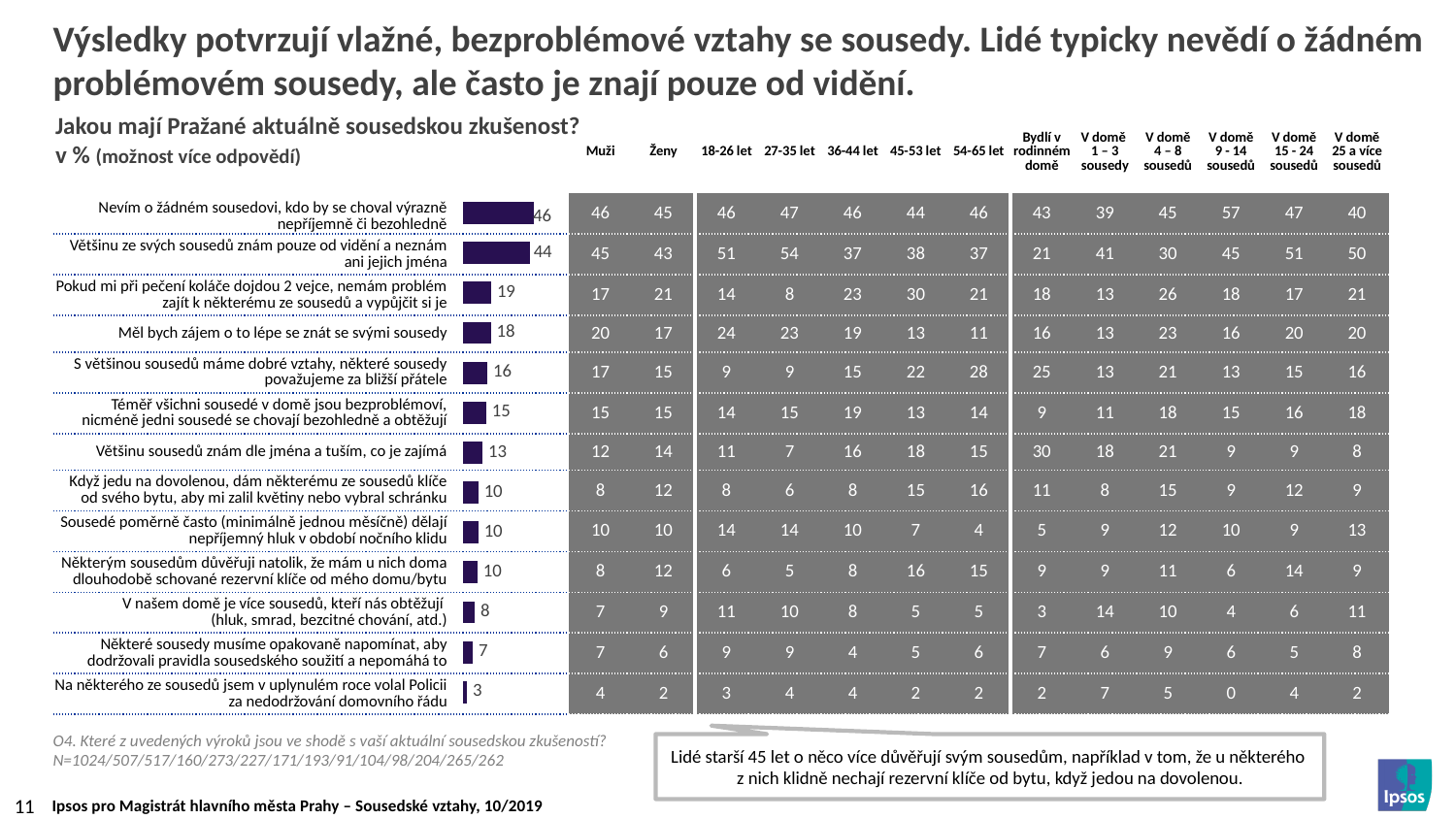
What percentage of respondents chose "Nevím o žádném sousedovi, kdo by se choval výrazně nepříjemně či bezohledně" in the bar chart? 46 In the bar chart, which is larger: the value for "S většinou sousedů máme dobré vztahy..." or for "Většinu sousedů znám dle jména a tuším, co je zajímá"? S většinou sousedů máme dobré vztahy... Which statement has the lowest value in the bar chart? Na některého ze sousedů jsem v uplynulém roce volal Policii za nedodržování domovního řádu In the bar chart, what is the difference between "Pokud mi při pečení koláče dojdou 2 vejce..." and "Některé sousedy musíme opakovaně napomínat..."? 12 Which statement has the highest value in the bar chart? Nevím o žádném sousedovi, kdo by se choval výrazně nepříjemně či bezohledně What is the difference between the values for "Nevím o žádném sousedovi..." (46) and "Většinu ze svých sousedů znám pouze od vidění..." (44) in the bar chart? 2 How many statements in the bar chart have a value of exactly 10? 3 What is the title of the chart on the slide? Jakou mají Pražané aktuálně sousedskou zkušenost? What value does the bar chart show for "Na některého ze sousedů jsem v uplynulém roce volal Policii za nedodržování domovního řádu"? 3 What value does the bar chart show for "Měl bych zájem o to lépe se znát se svými sousedy"? 18 What type of chart is used to show the overall results on the slide? Bar chart How many statements (bars) are shown in the bar chart? 13